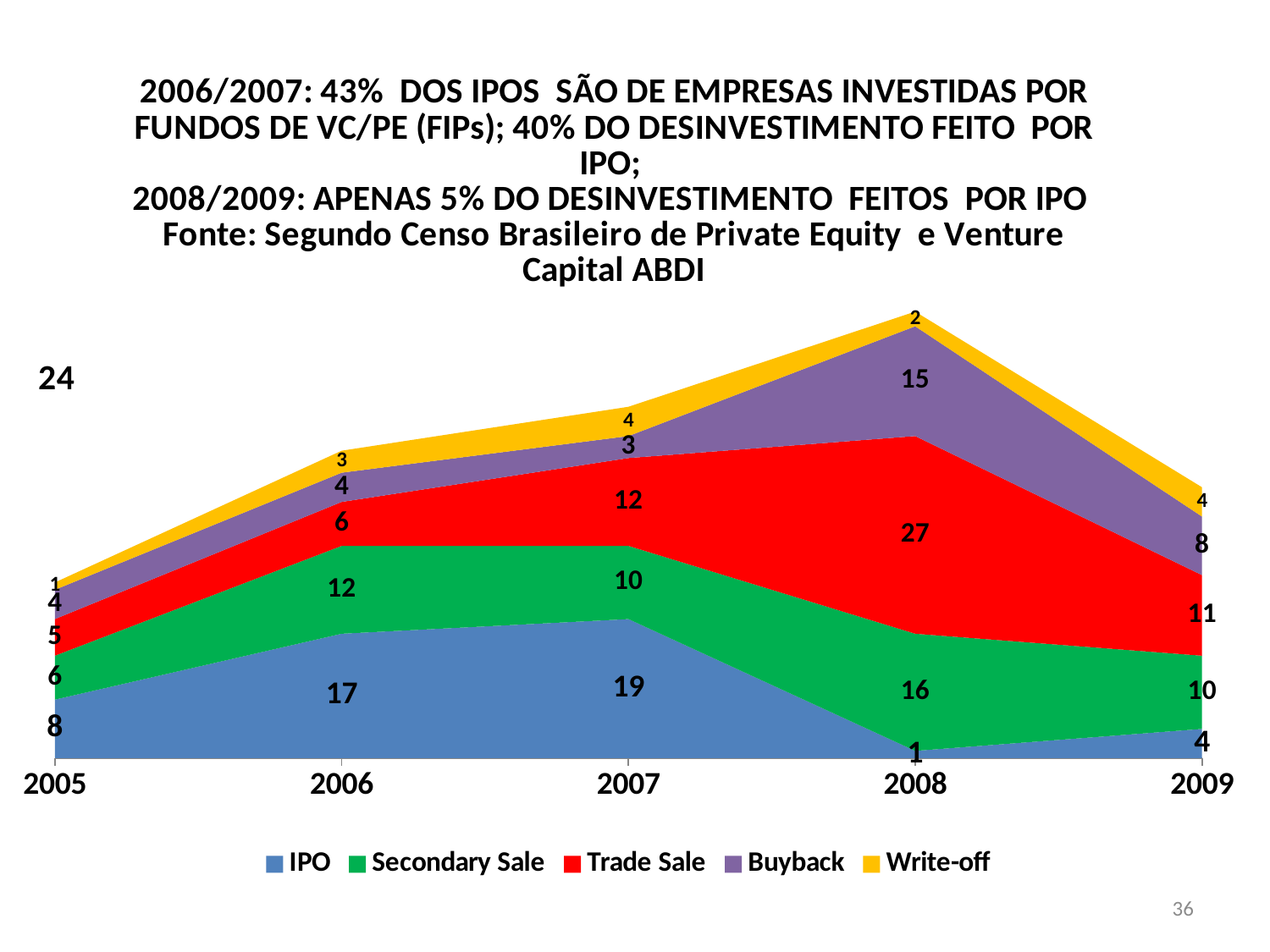
Which year has the larger Buyback value, 2008 or 2009? 2008 What is the IPO value for 2007? 19 How many years are shown on the x axis? 5 What is the total of all series for 2008? 61 What is the Write-off value for 2006? 3 What is the Trade Sale value for 2008? 27 In which year is the IPO value lowest? 2008 Does the IPO value rise or fall from 2007 to 2009? Fall What kind of chart is shown on the slide? Stacked area chart What is the difference between the Secondary Sale values for 2006 and 2009? 2 In which year is the IPO value highest? 2007 How many series does the legend list? 5